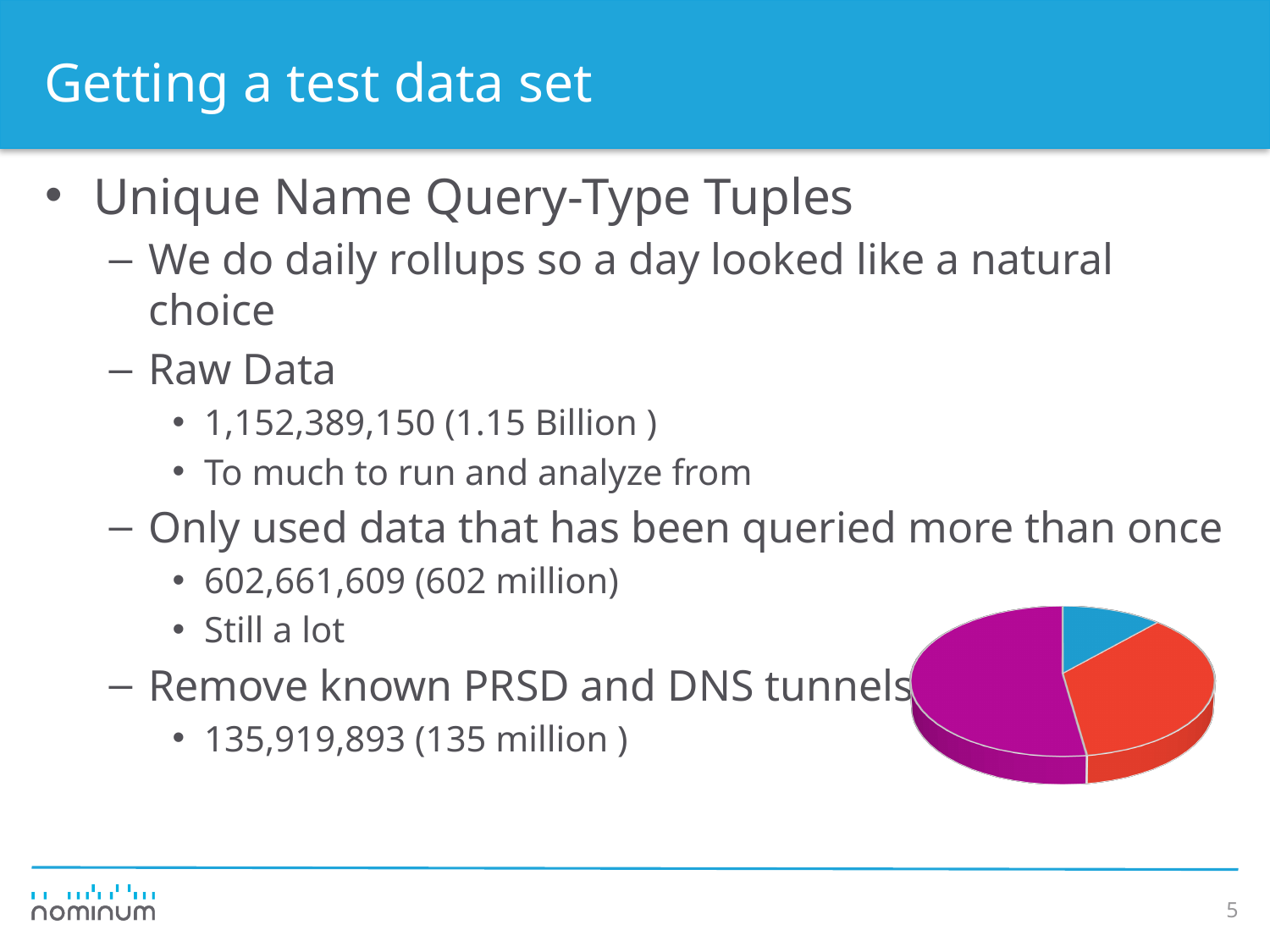
Which colour slice is the largest in the pie chart? magenta What kind of chart is shown on the slide? pie chart In the pie chart, which is larger, the magenta slice or the blue slice? magenta Does the pie chart display a legend? No Does the pie chart show data labels with values on its slices? No Which colour slice is the smallest in the pie chart? blue In the pie chart, which is larger, the red slice or the blue slice? red How many slices does the pie chart have? 3